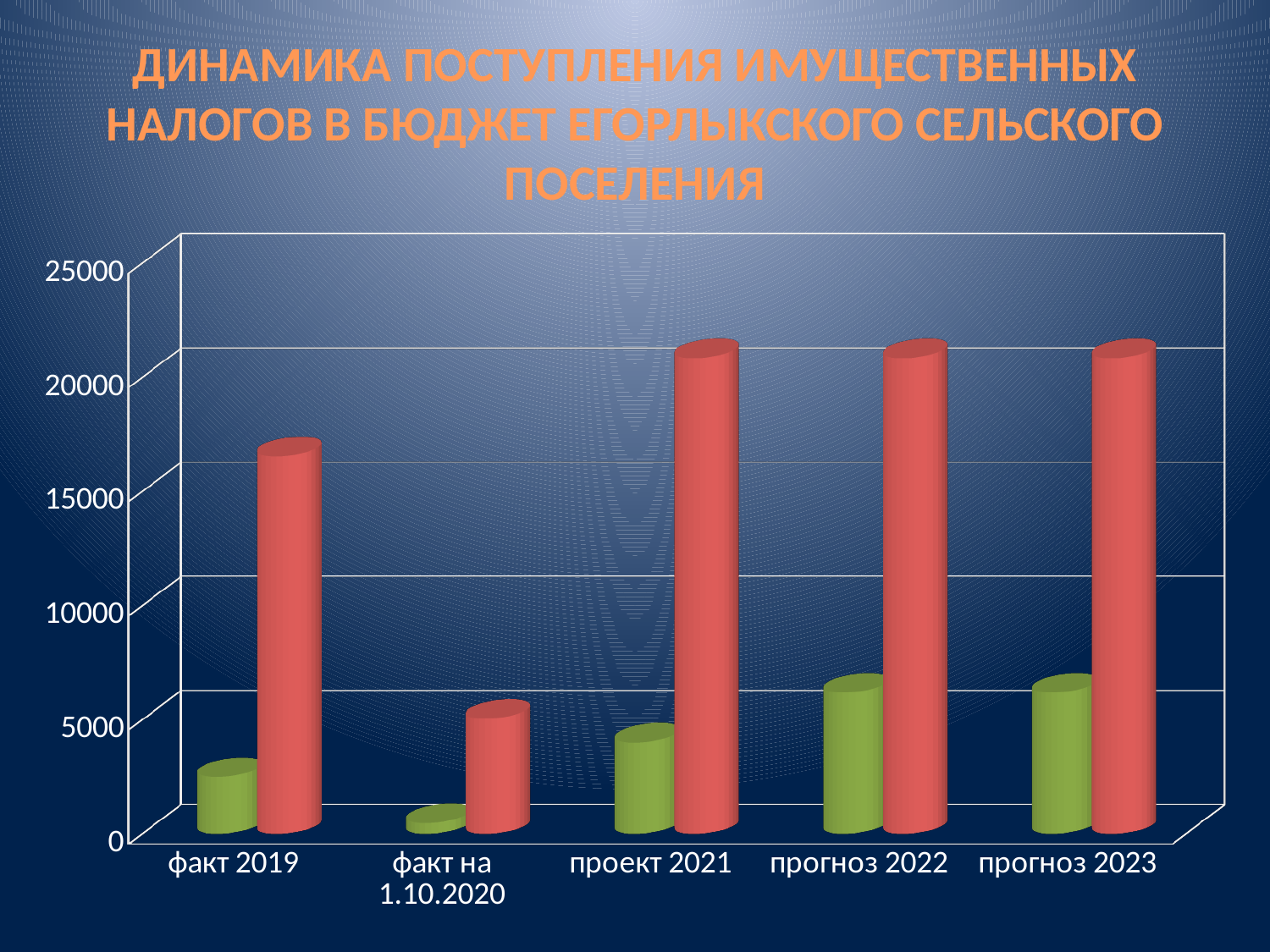
How many categories are shown along the x axis of the chart? 5 Is the value of the red bar for факт 2019 greater or less than 15000? greater Which category has the lowest red bar? факт на 1.10.2020 What two colours are used for the bars in the chart? green and red Which red bar is taller: факт 2019 or проект 2021? проект 2021 Is the value of the green bar for факт 2019 greater or less than 5000? less Which category has the lowest green bar? факт на 1.10.2020 Is the value of the green bar for прогноз 2022 greater or less than 5000? greater What is the title of the chart on the slide? ДИНАМИКА ПОСТУПЛЕНИЯ ИМУЩЕСТВЕННЫХ НАЛОГОВ В БЮДЖЕТ ЕГОРЛЫКСКОГО СЕЛЬСКОГО ПОСЕЛЕНИЯ What kind of chart is shown on the slide? bar chart